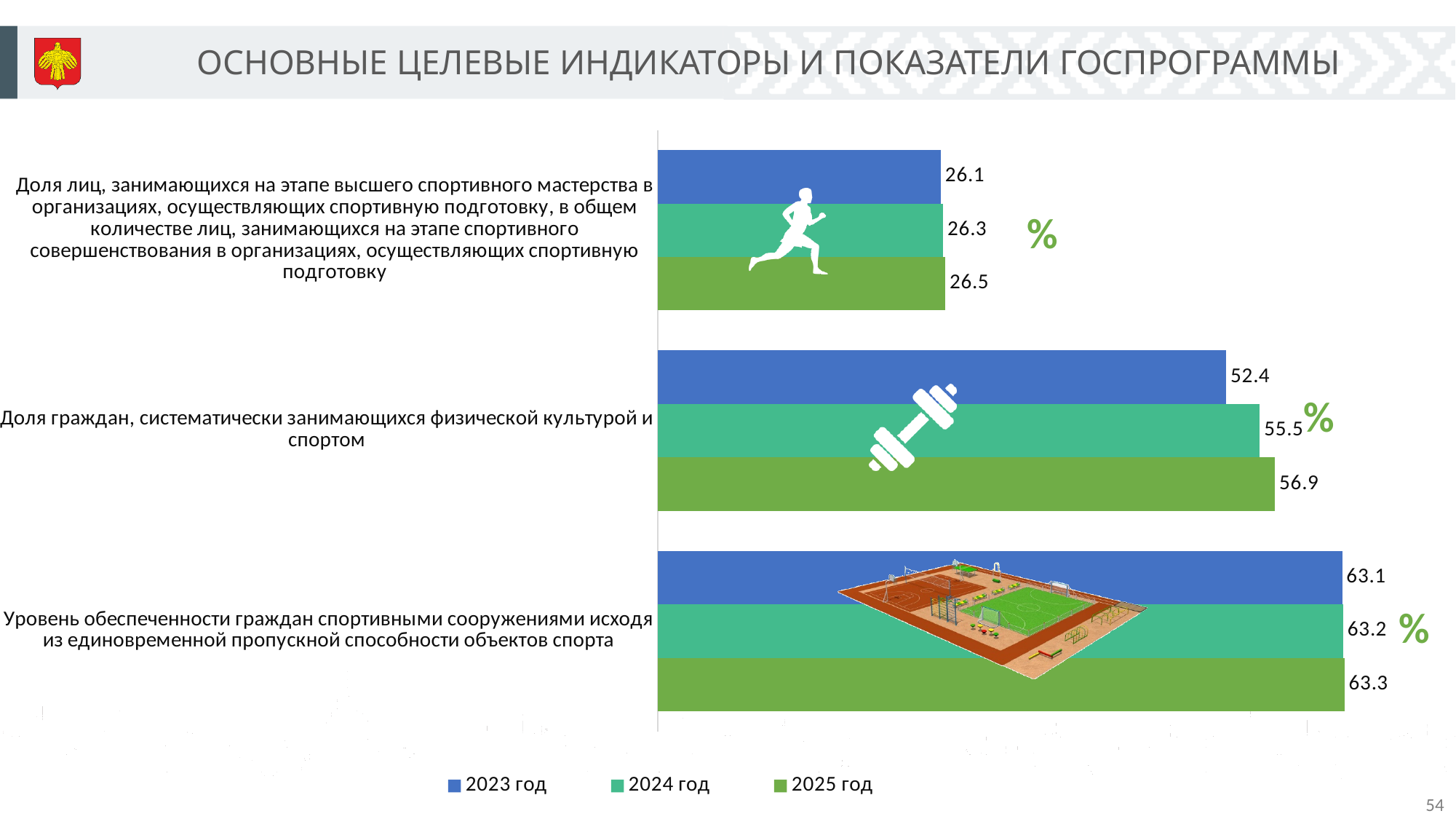
Which is larger: the 2024 год value for 'Доля граждан, систематически занимающихся физической культурой и спортом' or the 2023 год value for 'Уровень обеспеченности граждан спортивными сооружениями...'? 2023 год value for 'Уровень обеспеченности граждан спортивными сооружениями...' (63.1) What kind of chart is shown on the slide? Bar chart How many categories (indicators) are shown in the chart? 3 Which category has the lowest value for 2023 год? Доля лиц, занимающихся на этапе высшего спортивного мастерства в организациях, осуществляющих спортивную подготовку Which year has the highest value for 'Доля граждан, систематически занимающихся физической культурой и спортом'? 2025 год What is the difference between the 2025 год and 2023 год values for 'Доля лиц, занимающихся на этапе высшего спортивного мастерства...'? 0.4 What is the value for 2023 год for 'Доля граждан, систематически занимающихся физической культурой и спортом'? 52.4 What is the value for 2024 год for 'Доля лиц, занимающихся на этапе высшего спортивного мастерства...'? 26.3 Do the values for 'Доля граждан, систематически занимающихся физической культурой и спортом' rise or fall from 2023 год to 2025 год? Rise What is the difference between the 2025 год and 2023 год values for 'Доля граждан, систематически занимающихся физической культурой и спортом'? 4.5 How many series does the legend list? 3 What is the value for 2025 год for 'Уровень обеспеченности граждан спортивными сооружениями исходя из единовременной пропускной способности объектов спорта'? 63.3